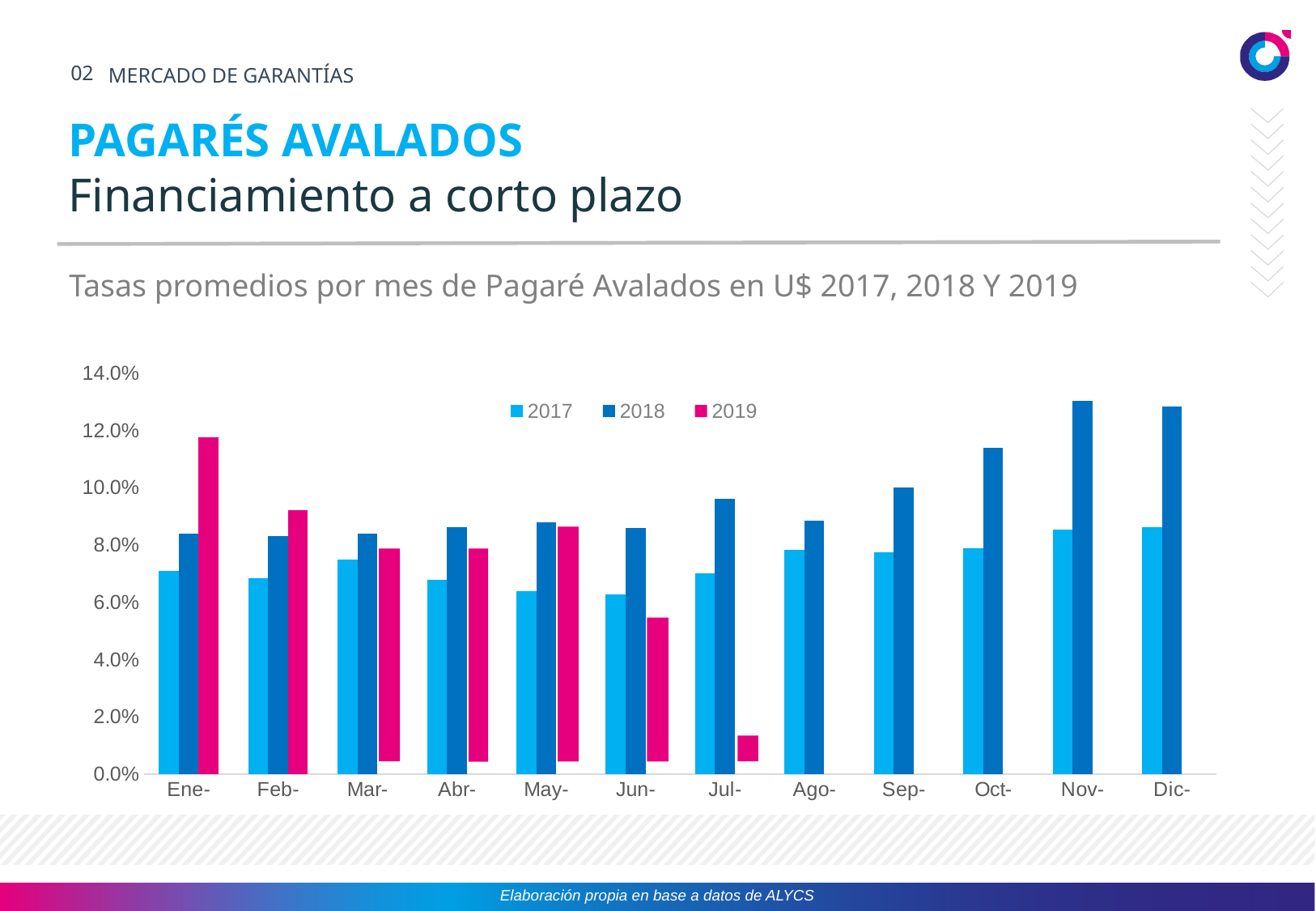
How many months are shown on the x axis? 12 Is the 2018 value for Oct- greater or less than 10.0%? greater In Jun-, which series has the larger value, 2018 or 2019? 2018 Which month has the highest value for the 2019 series? Ene- What kind of chart is shown on the slide? bar chart Is the 2019 value for Ene- greater or less than 10.0%? greater Which month has the highest value for the 2018 series? Nov- Which month has the lowest value for the 2019 series? Jul- Is the 2019 value for Jul- greater or less than 2.0%? less Does the 2018 series rise or fall from Sep- to Nov-? rise For how many months is a 2019 bar plotted? 7 How many series does the legend list? 3